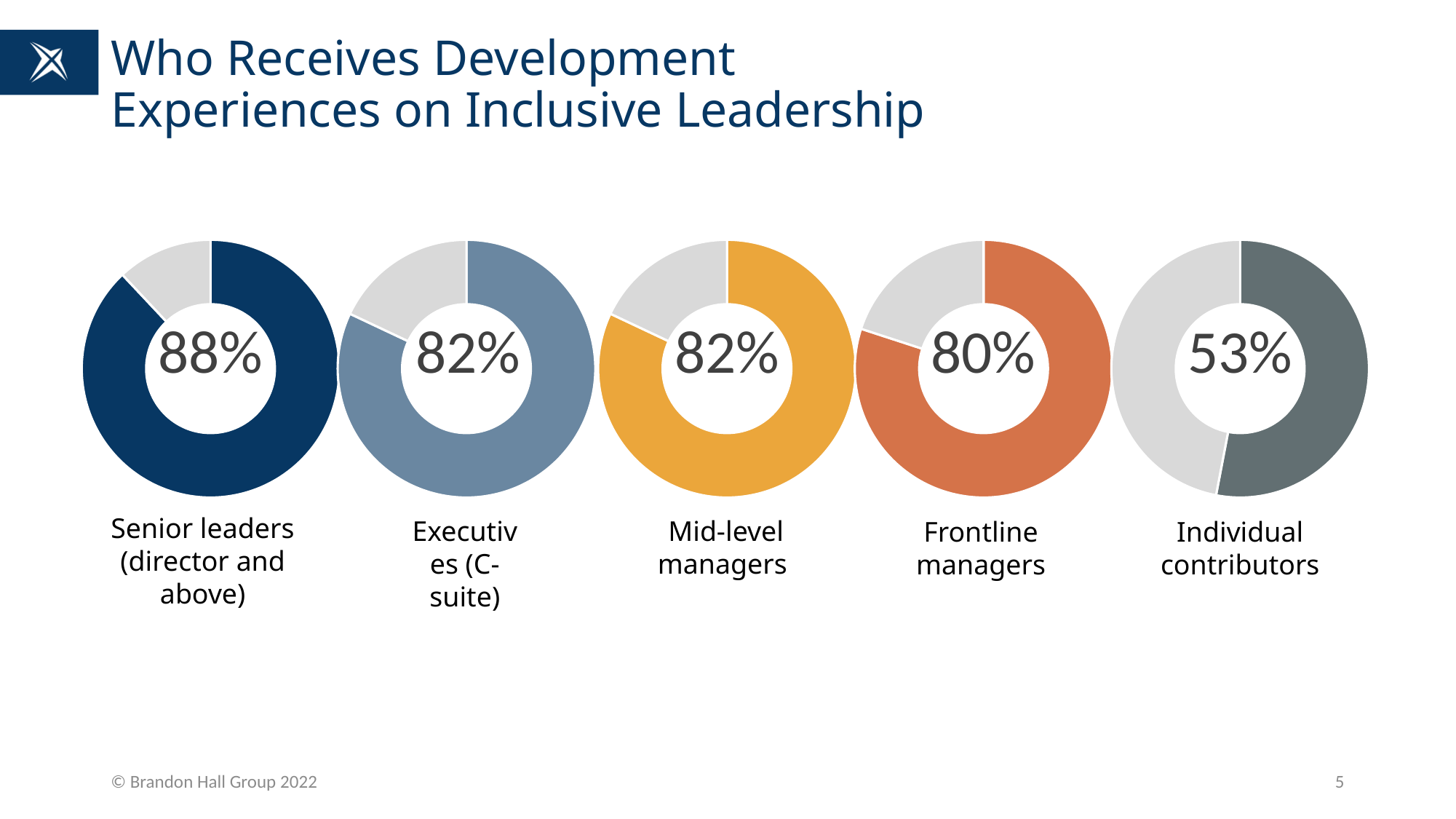
What is the difference in percentage points between senior leaders (director and above) and individual contributors? 35 What percentage of senior leaders (director and above) receive development experiences on inclusive leadership? 88% What percentage is shown for executives (C-suite)? 82% What percentage is shown for individual contributors? 53% What percentage is shown for mid-level managers? 82% What percentage is shown for frontline managers? 80% Which group has the lowest percentage receiving development experiences on inclusive leadership? Individual contributors What is the difference in percentage points between frontline managers and individual contributors? 27 How many groups are shown on the slide? 5 What kind of chart is used to show each group's percentage? Doughnut chart Which group has the highest percentage receiving development experiences on inclusive leadership? Senior leaders (director and above) Which is larger, the percentage for frontline managers or for individual contributors? Frontline managers